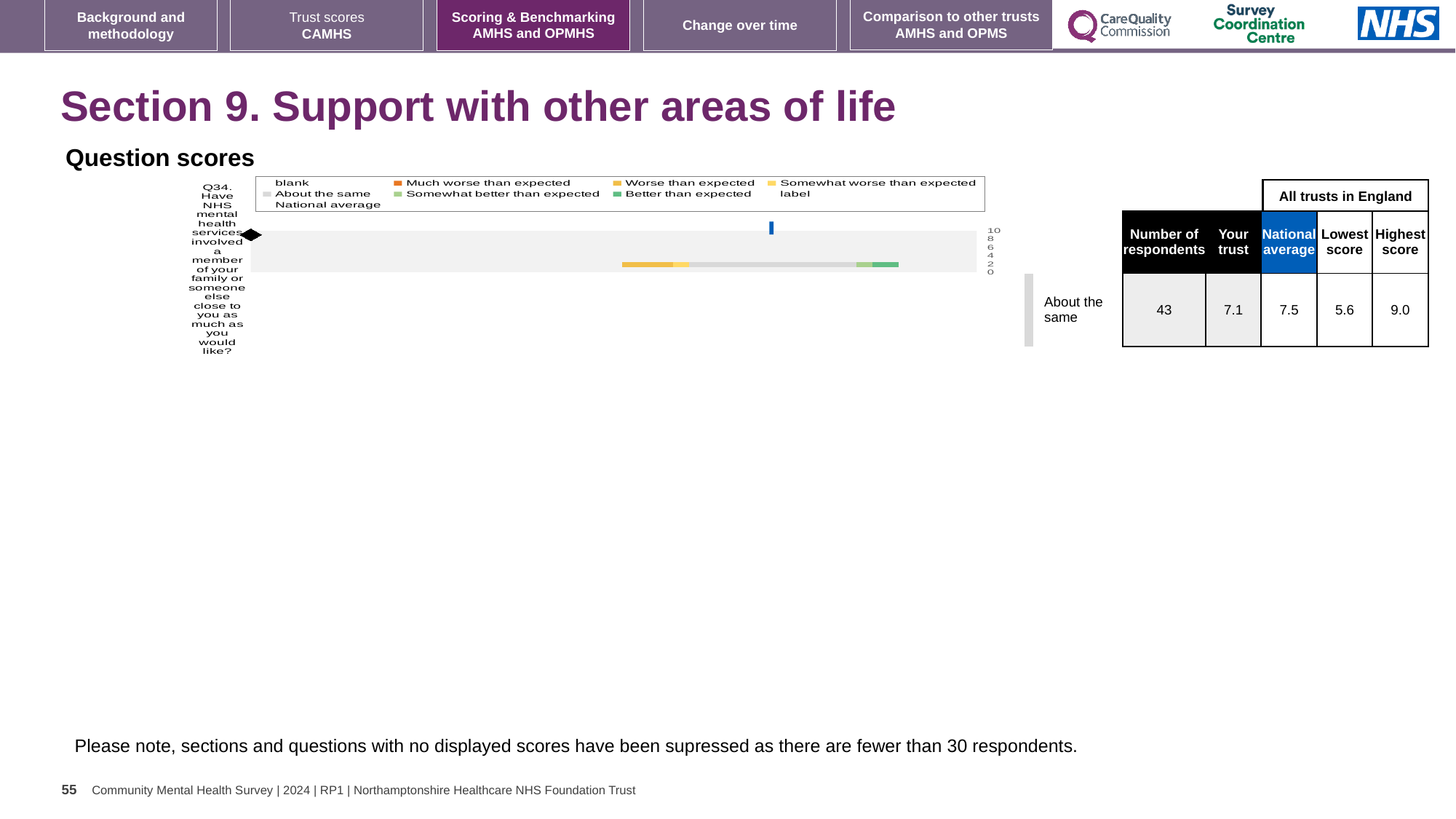
For Q34, which is higher: the trust's score or the national average? National average What is the highest score among all trusts in England for Q34? 9.0 What is the difference between the national average and the trust's score for Q34? 0.4 How many respondents answered Q34? 43 What type of chart is used to show the Q34 question score? bar chart What is the 'Your trust' score for Q34? 7.1 Which benchmark category is Q34 placed in, according to the label next to the chart? About the same What is the lowest score among all trusts in England for Q34? 5.6 What is the highest value shown on the score axis of the Question scores chart? 10 What is the national average score for Q34? 7.5 How many survey questions are plotted in the Question scores chart? 1